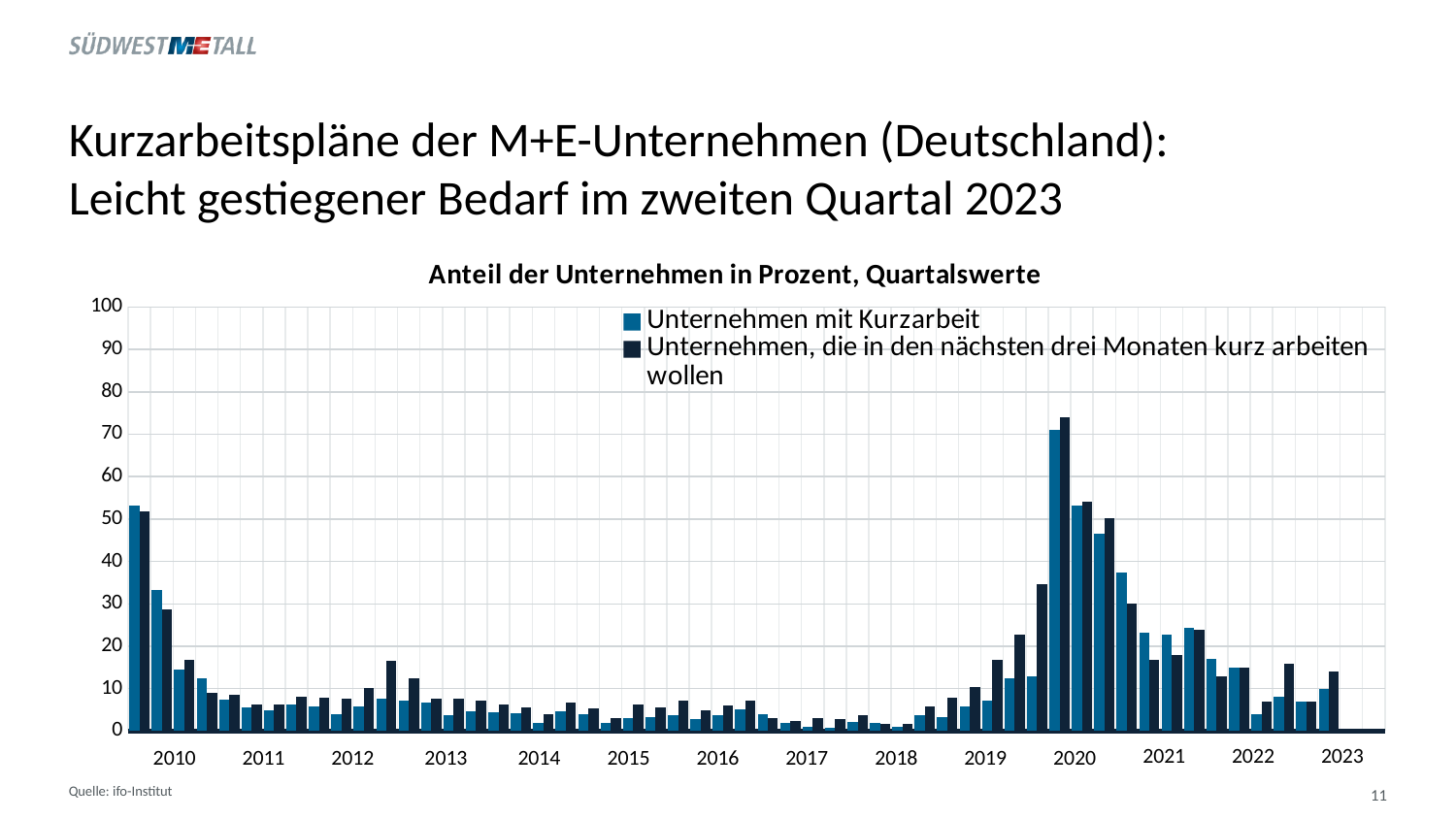
Do the values rise or fall from the start of 2010 to 2013? fall Are the values for 'Unternehmen mit Kurzarbeit' in 2017 greater or less than 10? less What is the name of the first series in the legend? Unternehmen mit Kurzarbeit What is the title of the chart? Anteil der Unternehmen in Prozent, Quartalswerte How many series does the legend list? 2 What kind of chart is shown on the slide? bar chart In which year do the bars reach their highest values? 2020 Is the first bar for 'Unternehmen mit Kurzarbeit' in 2010 greater or less than 40? greater Which is larger: the peak value in 2010 or the peak value in 2020? 2020 Do the values rise or fall from the 2020 peak to 2022? fall Are the values for 'Unternehmen mit Kurzarbeit' in 2014 greater or less than 20? less